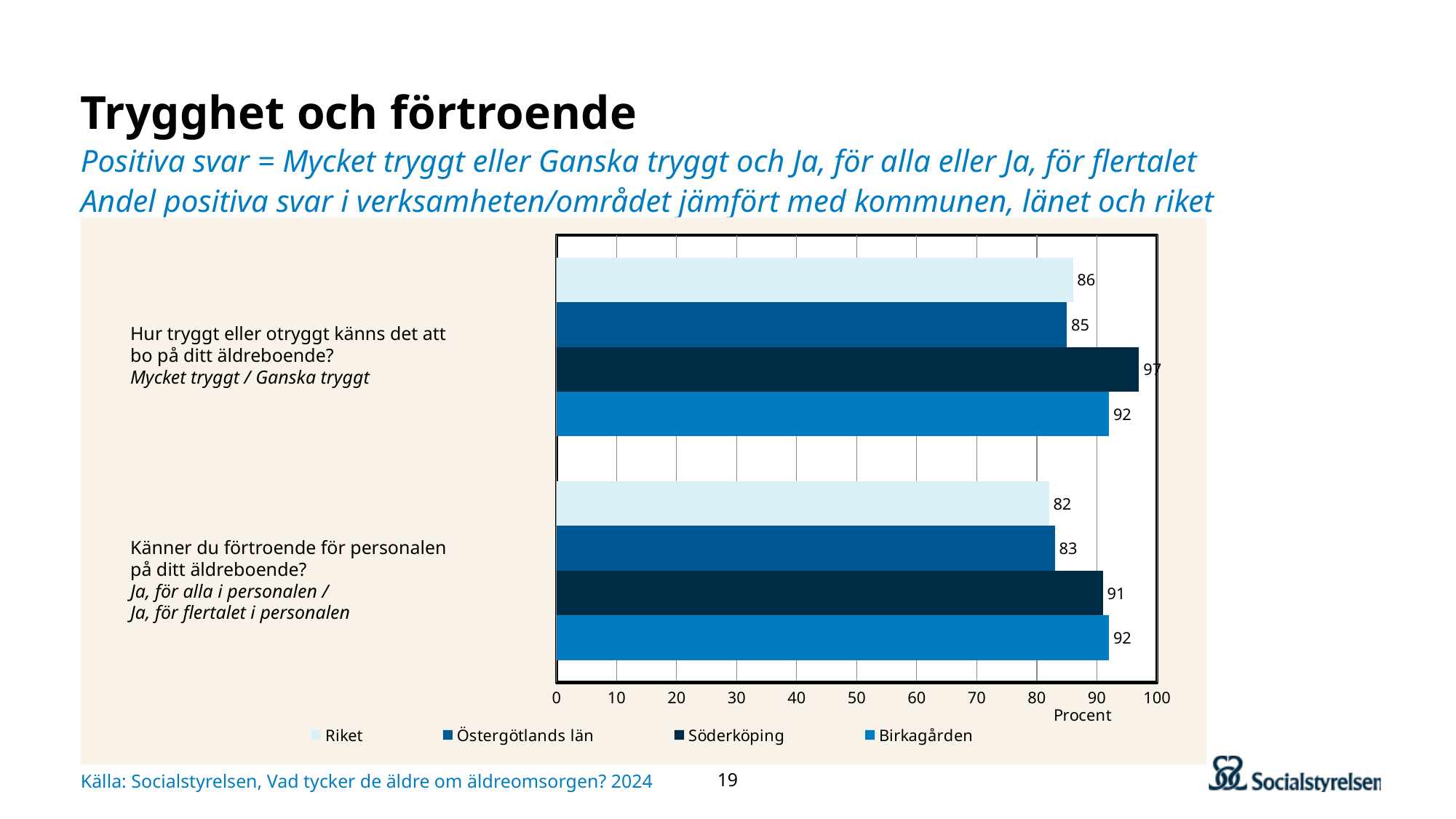
Is the value for Riket on the question "Känner du förtroende för personalen på ditt äldreboende?" greater or less than 90? less Which series has the highest value on the question "Hur tryggt eller otryggt känns det att bo på ditt äldreboende?"? Söderköping What is the difference between Söderköping and Riket on the question "Hur tryggt eller otryggt känns det att bo på ditt äldreboende?"? 11 What is the value for Birkagården on the question "Hur tryggt eller otryggt känns det att bo på ditt äldreboende?"? 92 How many series does the legend list? 4 What kind of chart is shown on the slide? Bar chart Which is larger on the question "Känner du förtroende för personalen på ditt äldreboende?": Söderköping or Birkagården? Birkagården What is the value for Söderköping on the question "Hur tryggt eller otryggt känns det att bo på ditt äldreboende?"? 97 Which series has the lowest value on the question "Känner du förtroende för personalen på ditt äldreboende?"? Riket What is the value for Östergötlands län on the question "Känner du förtroende för personalen på ditt äldreboende?"? 83 What unit is shown on the x axis of the chart? Procent What is the value for Riket on the question "Känner du förtroende för personalen på ditt äldreboende?"? 82